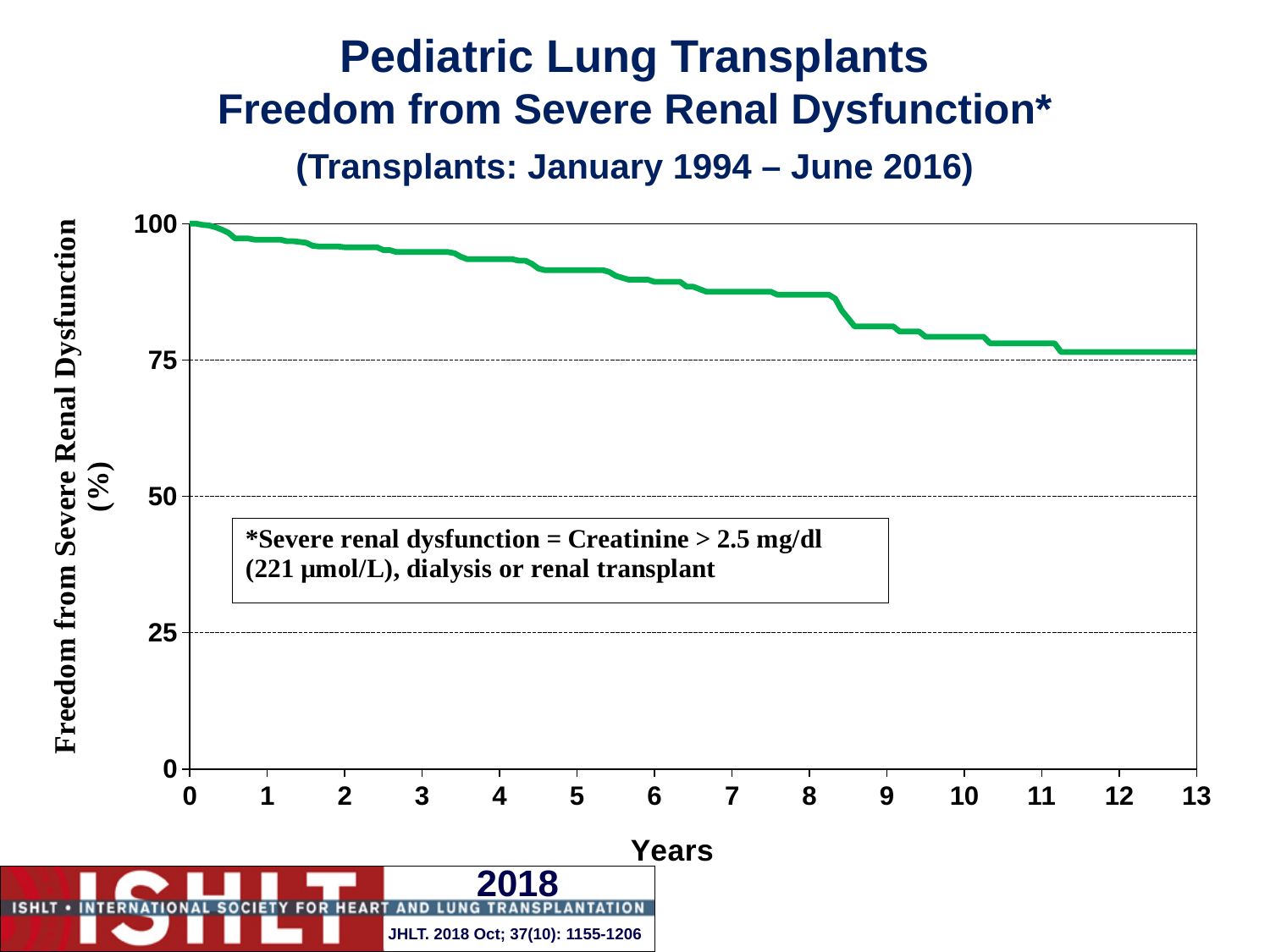
Is the freedom from severe renal dysfunction at year 2 greater or less than 50? greater Is the freedom from severe renal dysfunction at year 8 greater or less than 75? greater What colour is the plotted line? green At which year on the x axis is the curve at its highest value? 0 Is the value of the curve higher at year 3 or at year 11? year 3 Is the freedom from severe renal dysfunction at year 10 greater or less than 100? less What is the freedom from severe renal dysfunction at year 0? 100 What is the label of the x axis? Years What kind of chart is shown on the slide? line chart Does the freedom from severe renal dysfunction rise or fall as years since transplant increase? fall